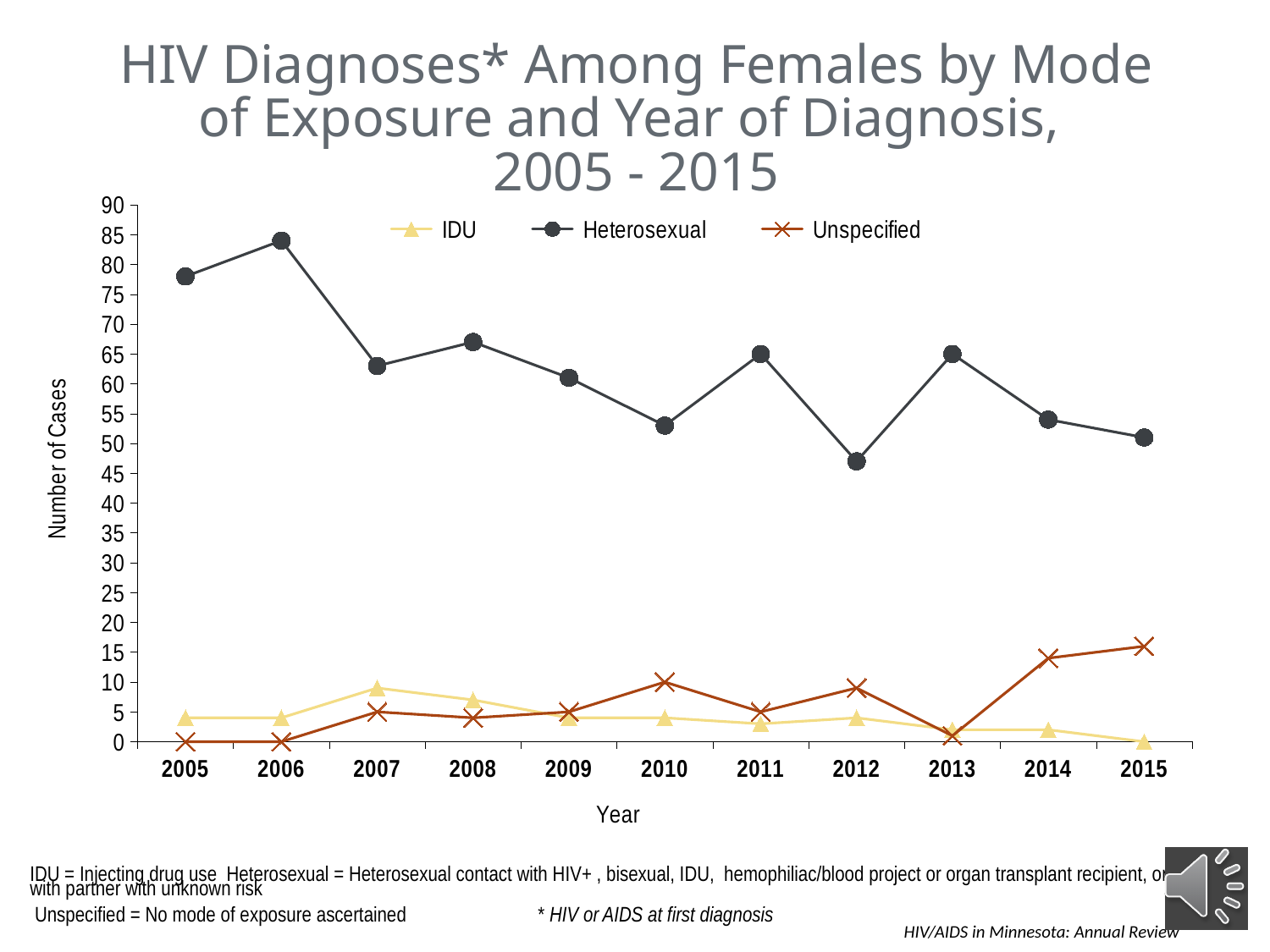
In which year was the Unspecified series highest? 2015 What kind of chart is shown on the slide? line chart What is the title of the y axis? Number of Cases In which year was the Heterosexual series highest? 2006 Does the Unspecified series rise or fall from 2013 to 2015? rise Is the Heterosexual value for 2005 greater or less than 75? greater What is the Unspecified value for 2005? 0 How many series does the legend list? 3 In which year was the Heterosexual series lowest? 2012 How many years are plotted along the x axis? 11 Is the Heterosexual value for 2012 greater or less than 50? less In 2015, which series has the larger value, Heterosexual or Unspecified? Heterosexual